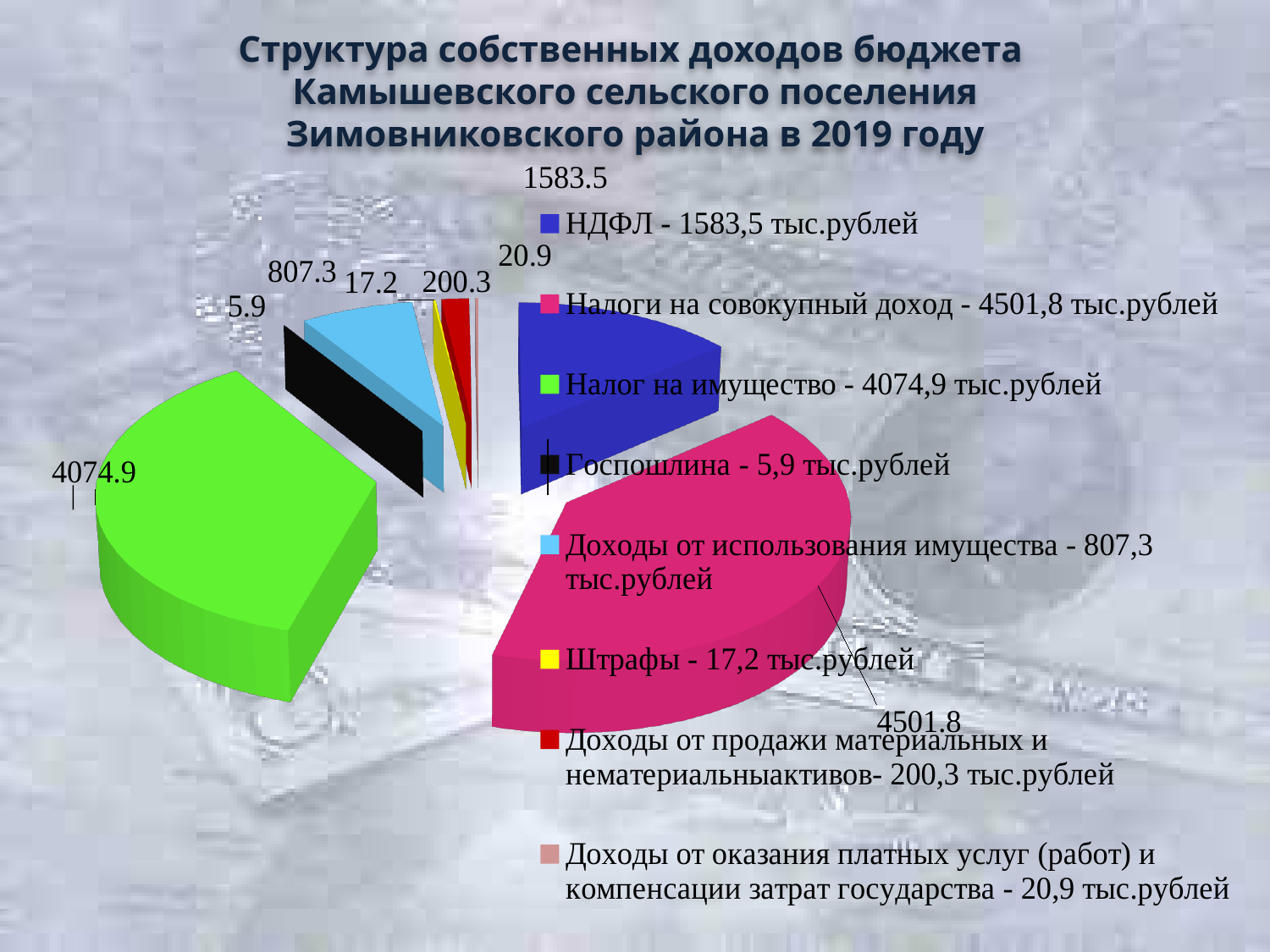
How many slices does the pie chart have? 8 What colour is the slice for Налог на имущество? Green What type of chart is shown on the slide? Pie chart What value is labelled on the slice for Налоги на совокупный доход? 4501.8 What value is labelled on the slice for Доходы от использования имущества? 807.3 Which is larger: the value for НДФЛ or the value for Доходы от использования имущества? НДФЛ What value is labelled on the slice for Налог на имущество? 4074.9 Which category has the smallest value in the pie chart? Госпошлина Which category has the largest slice of the pie? Налоги на совокупный доход What is the difference between the values for Налоги на совокупный доход and Налог на имущество? 426.9 How many entries does the legend list? 8 What value is labelled on the slice for НДФЛ? 1583.5